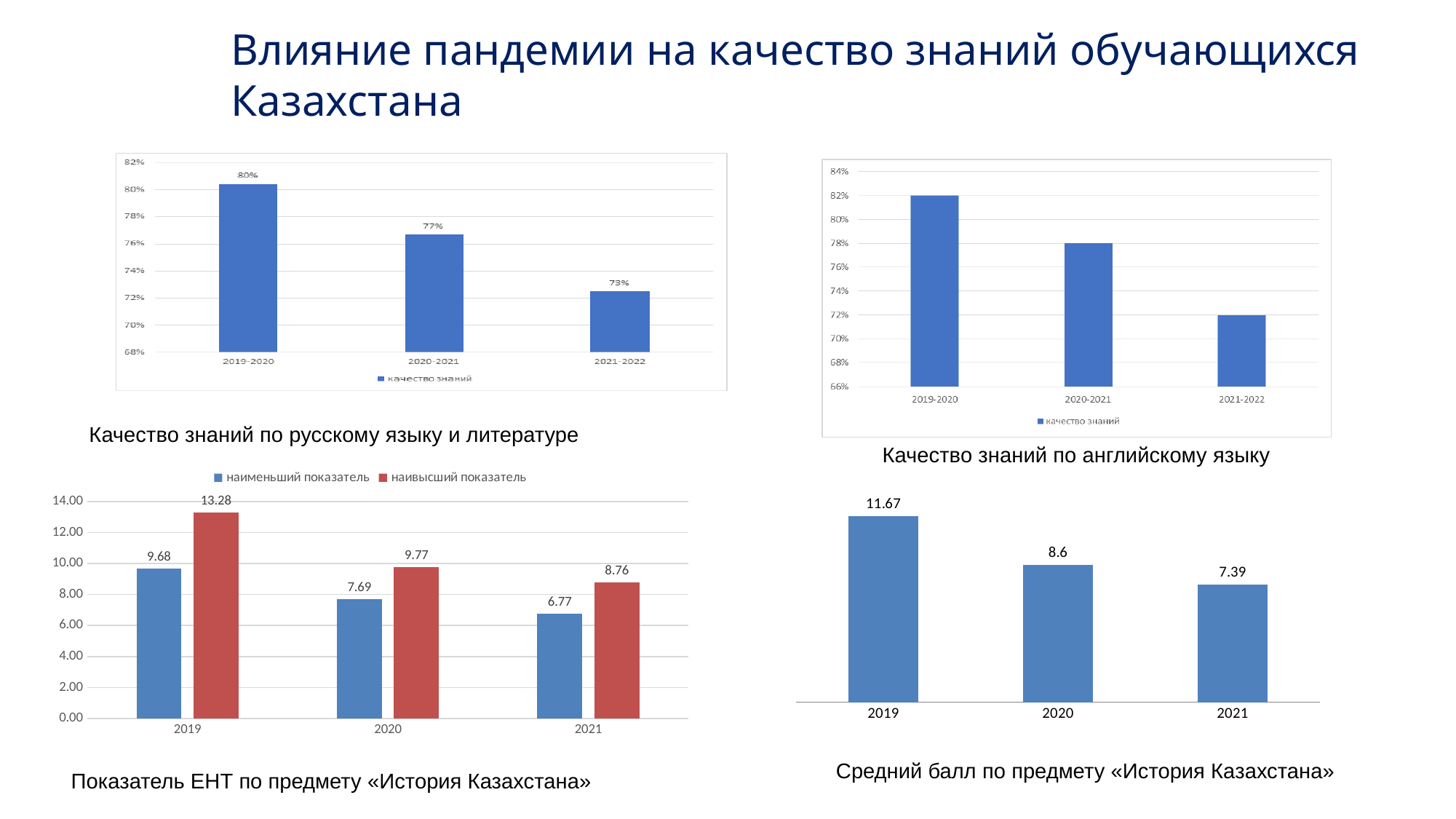
In the chart 'Качество знаний по английскому языку', do the values rise or fall from 2019-2020 to 2021-2022? fall In the chart 'Средний балл по предмету «История Казахстана»', what is the value for 2020? 8.6 In the chart 'Качество знаний по русскому языку и литературе', what is the difference between the 2019-2020 and 2021-2022 values? 7% In the chart 'Показатель ЕНТ по предмету «История Казахстана»', what is the value of 'наивысший показатель' for 2020? 9.77 In the chart 'Показатель ЕНТ по предмету «История Казахстана»', what is the difference between 'наивысший показатель' and 'наименьший показатель' in 2019? 3.60 In the chart 'Средний балл по предмету «История Казахстана»', which year has the highest value? 2019 In the chart 'Качество знаний по русскому языку и литературе', which year has the lowest value? 2021-2022 What kind of chart is 'Средний балл по предмету «История Казахстана»'? bar chart In the chart 'Качество знаний по английскому языку', is the value for 2019-2020 greater or less than 80%? greater In the chart 'Качество знаний по русскому языку и литературе', what is the value for 2020-2021? 77% In the chart 'Показатель ЕНТ по предмету «История Казахстана»', how many series does the legend list? 2 In the chart 'Качество знаний по английскому языку', is the value for 2021-2022 greater or less than 74%? less